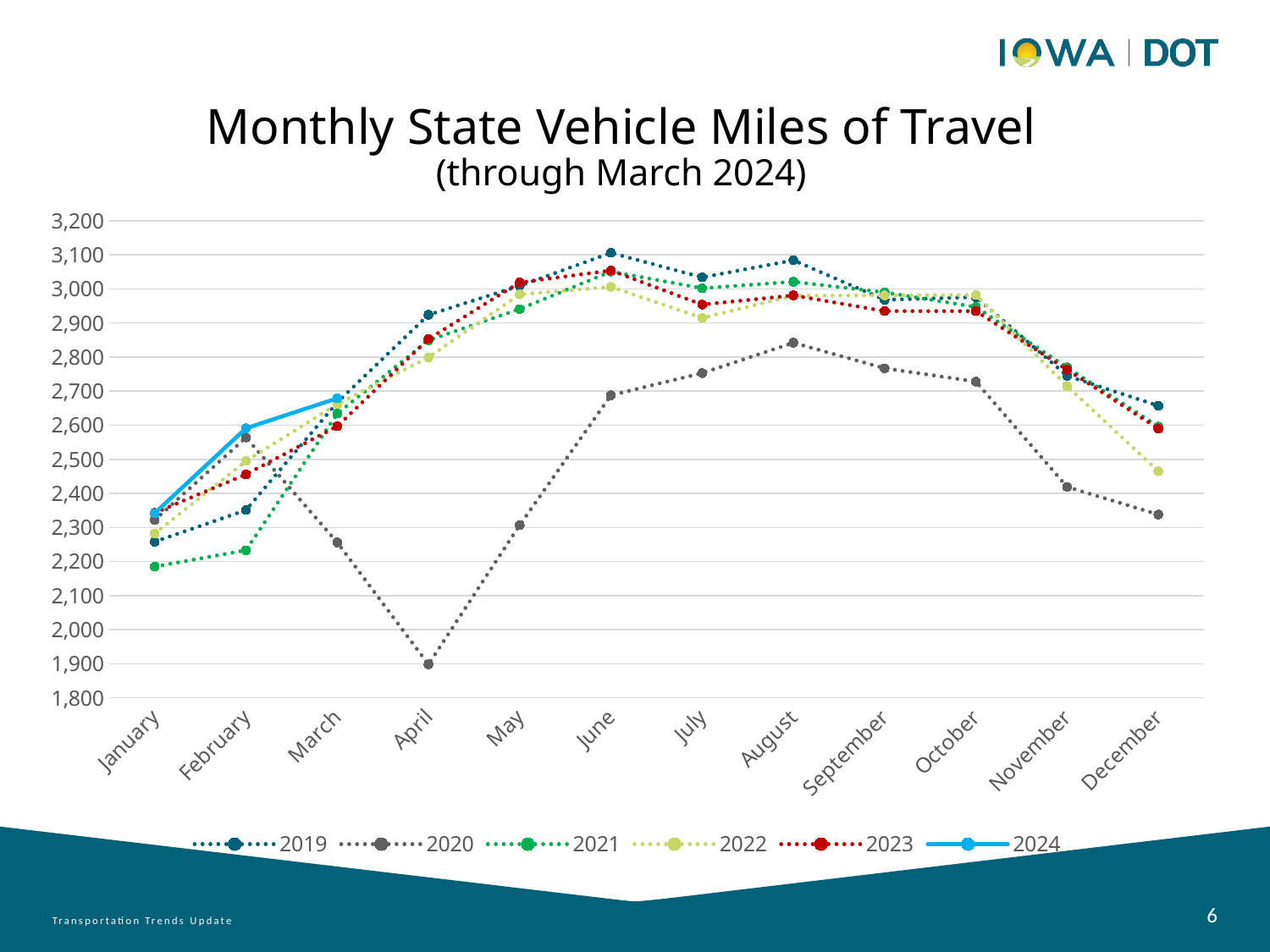
Which is larger in June, the 2019 value or the 2020 value? 2019 How many series does the legend list? 6 How many months are shown along the x axis? 12 What kind of chart is shown on the slide? line chart Which series is drawn as a solid line rather than a dotted line? 2024 Does the 2020 line rise or fall from March to April? fall Is the 2020 value for April greater or less than 2,000? less Which year has the highest value in June? 2019 Is the 2019 value for June greater or less than 3,000? greater Which year has the lowest value in April? 2020 Which year has the lowest value in January? 2021 Is the 2024 value for March greater or less than 2,600? greater